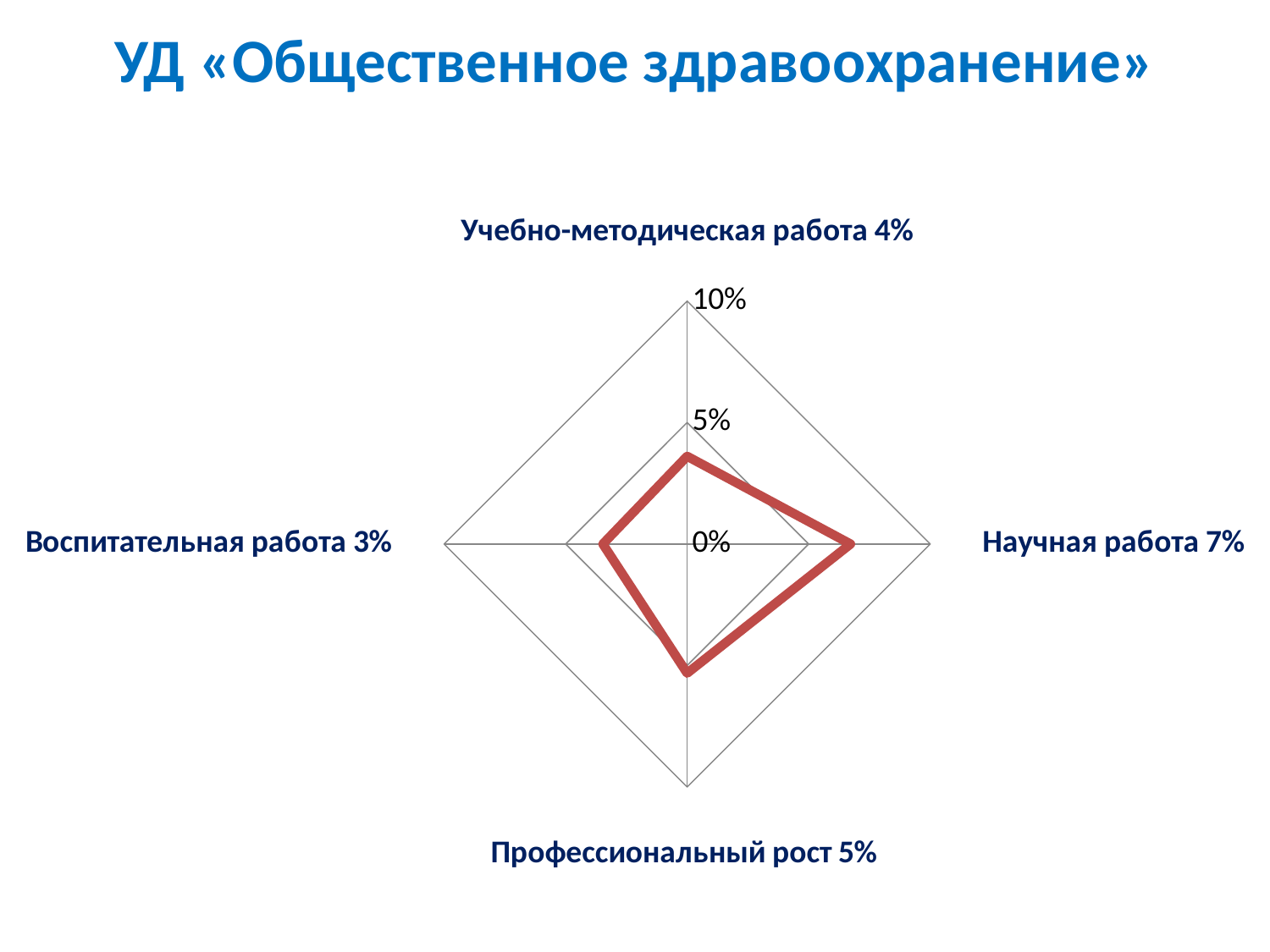
What is the value for Воспитательная работа? 3% Which category has the highest value? Научная работа Which category has the lowest value? Воспитательная работа What kind of chart is shown on the slide? radar chart What is the value for Учебно-методическая работа? 4% What is the value for Профессиональный рост? 5% What is the difference between the values for Профессиональный рост and Учебно-методическая работа? 1% What is the value for Научная работа? 7% Which is larger, the value for Научная работа or the value for Профессиональный рост? Научная работа What is the difference between the values for Научная работа and Воспитательная работа? 4% How many categories does the chart show? 4 Is the value for Научная работа greater or less than 5%? greater